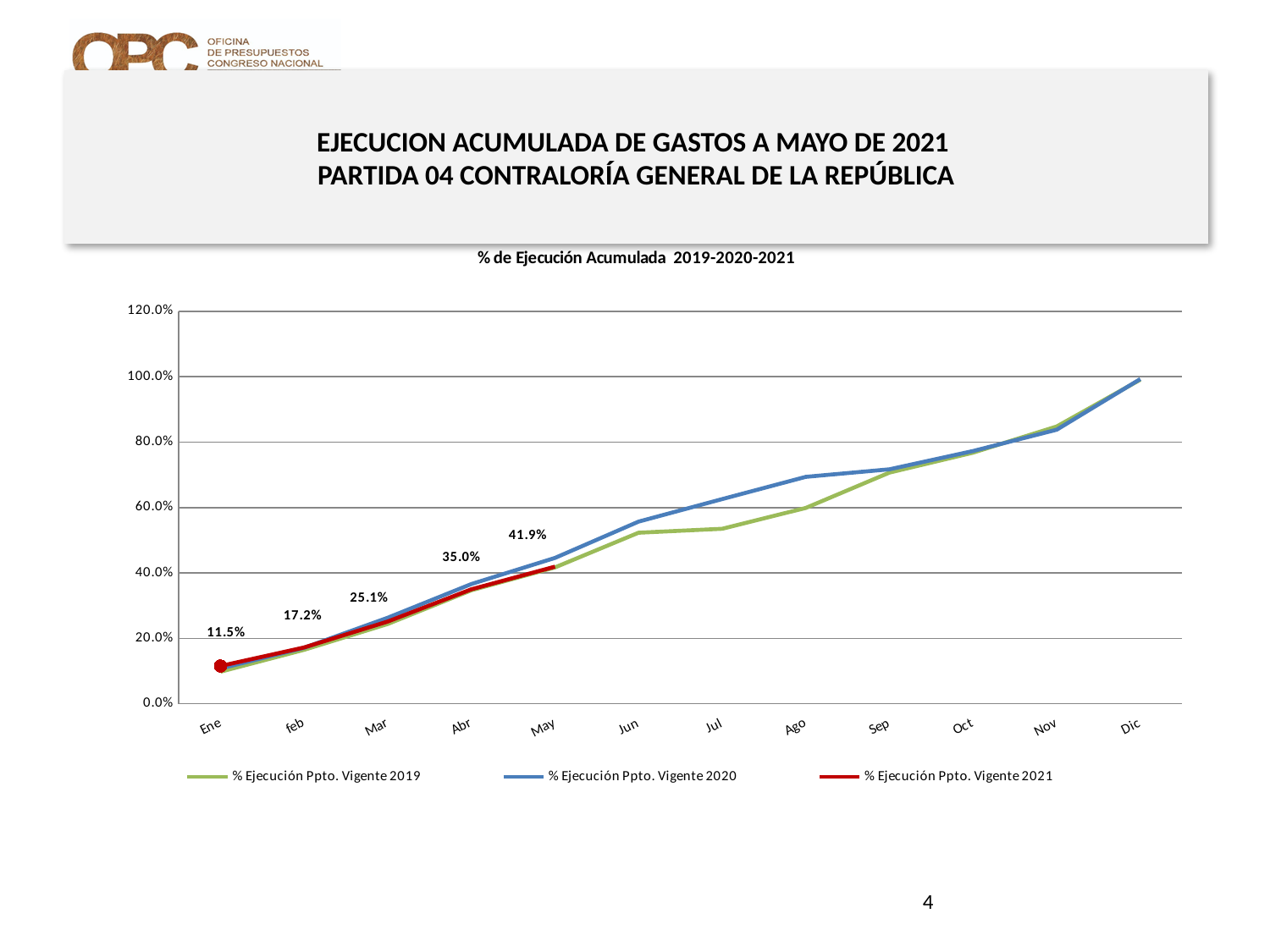
What is the difference between the 2021 values for Feb and Ene? 5.7% What is the value of % Ejecución Ppto. Vigente 2021 in May? 41.9% How many months are shown on the x axis? 12 What is the title of the chart? % de Ejecución Acumulada 2019-2020-2021 Does the % Ejecución Ppto. Vigente 2021 line rise or fall from Ene to May? Rise What is the difference between the 2021 values for May and Abr? 6.9% Is the value for % Ejecución Ppto. Vigente 2020 in Ago greater or less than 60.0%? greater What is the value of % Ejecución Ppto. Vigente 2021 in Ene? 11.5% What is the value of % Ejecución Ppto. Vigente 2021 in Mar? 25.1% In Ago, which series has the larger value: % Ejecución Ppto. Vigente 2019 or % Ejecución Ppto. Vigente 2020? % Ejecución Ppto. Vigente 2020 What kind of chart is shown on the slide? Line chart How many series does the legend list? 3